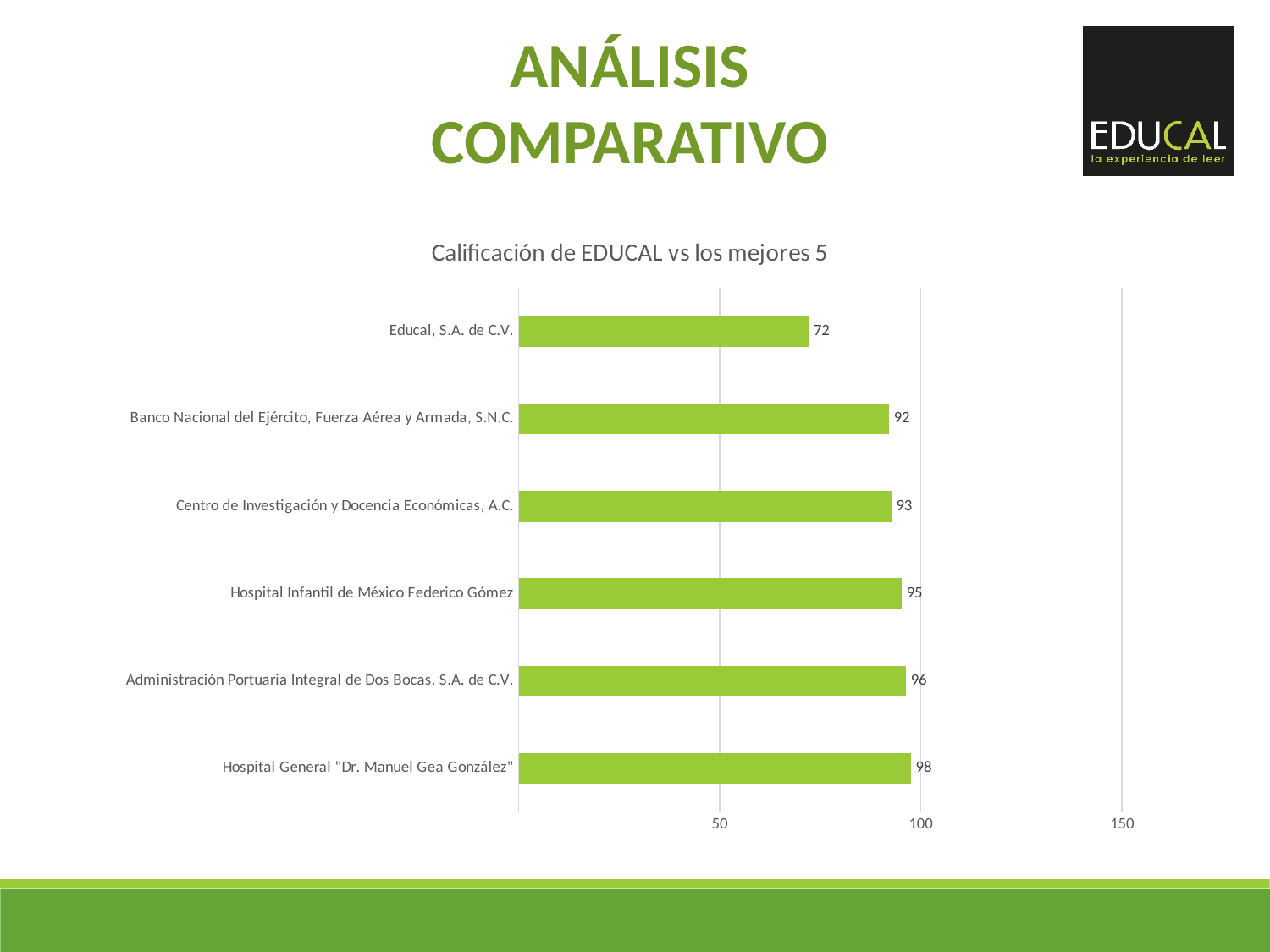
What is the title of the chart? Calificación de EDUCAL vs los mejores 5 Which category has the lowest value? Educal, S.A. de C.V. What colour are the bars in the chart? green What is the value for Hospital General "Dr. Manuel Gea González"? 98 What kind of chart is shown on the slide? bar chart Which has a larger value, Hospital Infantil de México Federico Gómez or Banco Nacional del Ejército, Fuerza Aérea y Armada, S.N.C.? Hospital Infantil de México Federico Gómez What is the value for Centro de Investigación y Docencia Económicas, A.C.? 93 What is the value for Educal, S.A. de C.V.? 72 How many categories are shown in the chart? 6 What is the difference between the values for Hospital General "Dr. Manuel Gea González" and Educal, S.A. de C.V.? 26 Is the value for Administración Portuaria Integral de Dos Bocas, S.A. de C.V. greater or less than 50? greater Which category has the highest value? Hospital General "Dr. Manuel Gea González"